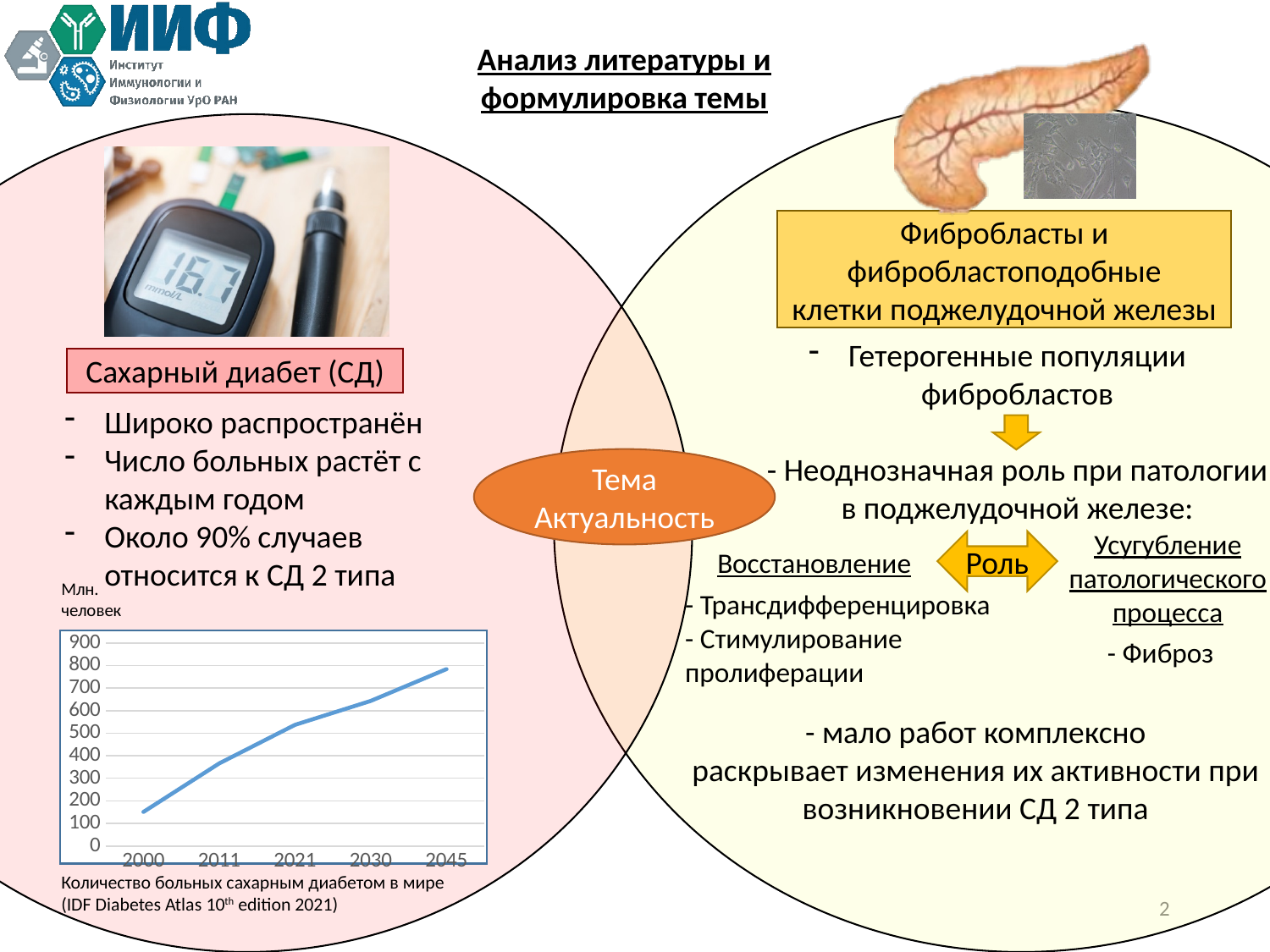
Do the values in the chart rise or fall from 2000 to 2045? rise How many years are marked on the x axis of the chart? 5 Is the value for 2045 greater or less than 700? greater Which year has the larger value, 2011 or 2030? 2030 What kind of chart is shown on the slide? line chart Is the value for 2021 greater or less than 500? greater What unit is written above the y axis of the chart? Млн. человек Is the value for 2000 greater or less than 200? less Which year has the lowest value in the chart? 2000 Which year has the highest value in the chart? 2045